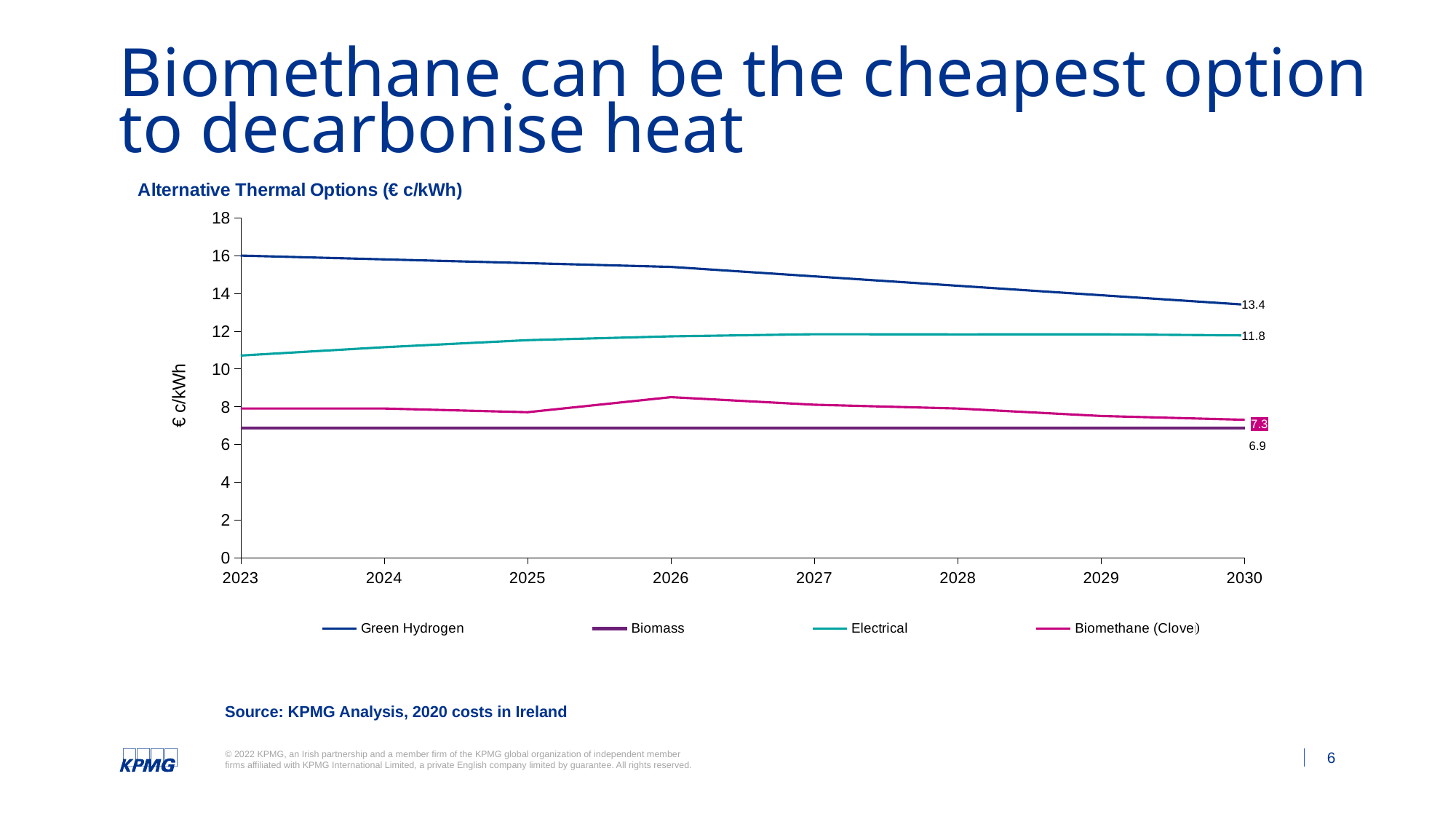
Does the Green Hydrogen line rise or fall from 2023 to 2030? Fall How many series does the legend list? 4 Which series has the highest value in 2030? Green Hydrogen What is the value for Biomass in 2030? 6.9 What is the value for Biomethane (Clover) in 2030? 7.3 What is the value for Electrical in 2030? 11.8 Which series has the lowest value in 2030? Biomass Is the value for Electrical in 2023 greater or less than 12? less What is the value for Green Hydrogen in 2030? 13.4 What kind of chart is shown on the slide? Line chart Is the value for Green Hydrogen in 2023 greater or less than 14? greater What is the difference between the Green Hydrogen and Electrical values in 2030? 1.6